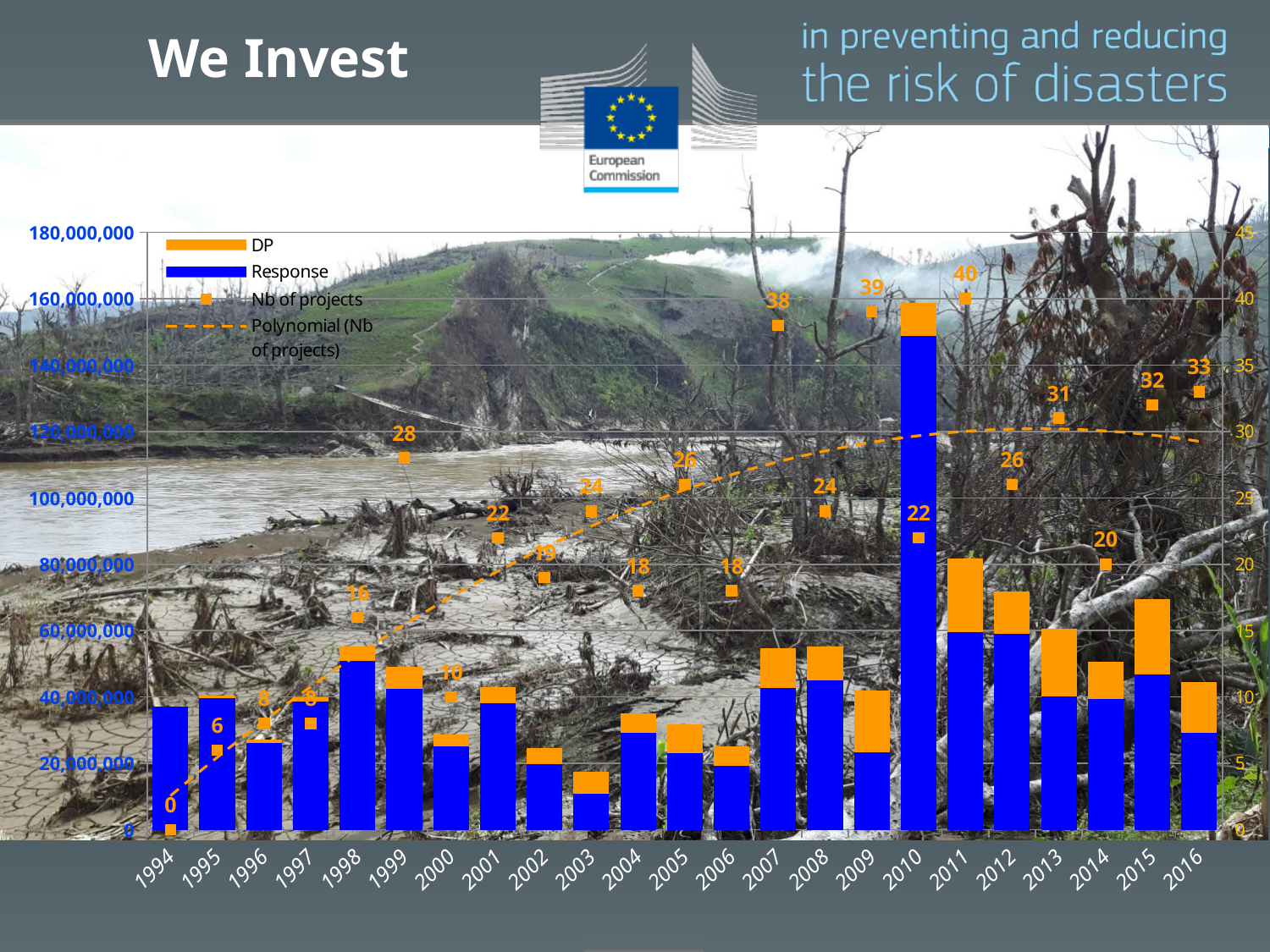
Is the total stacked bar (DP plus Response) for 2010 greater or less than 140,000,000? greater How many entries does the legend list? 4 Which year has the lowest Nb of projects? 1994 What is the Nb of projects value for 1999? 28 Which year has the highest Nb of projects? 2011 What is the Nb of projects value for 2005? 26 How many years are shown on the x axis? 23 Is the total stacked bar for 2003 greater or less than 20,000,000? less What is the difference in Nb of projects between 2016 and 2014? 13 How many projects (Nb of projects) are shown for 2011? 40 Which year has the tallest stacked bar? 2010 Which year has more projects, 2007 or 2009? 2009